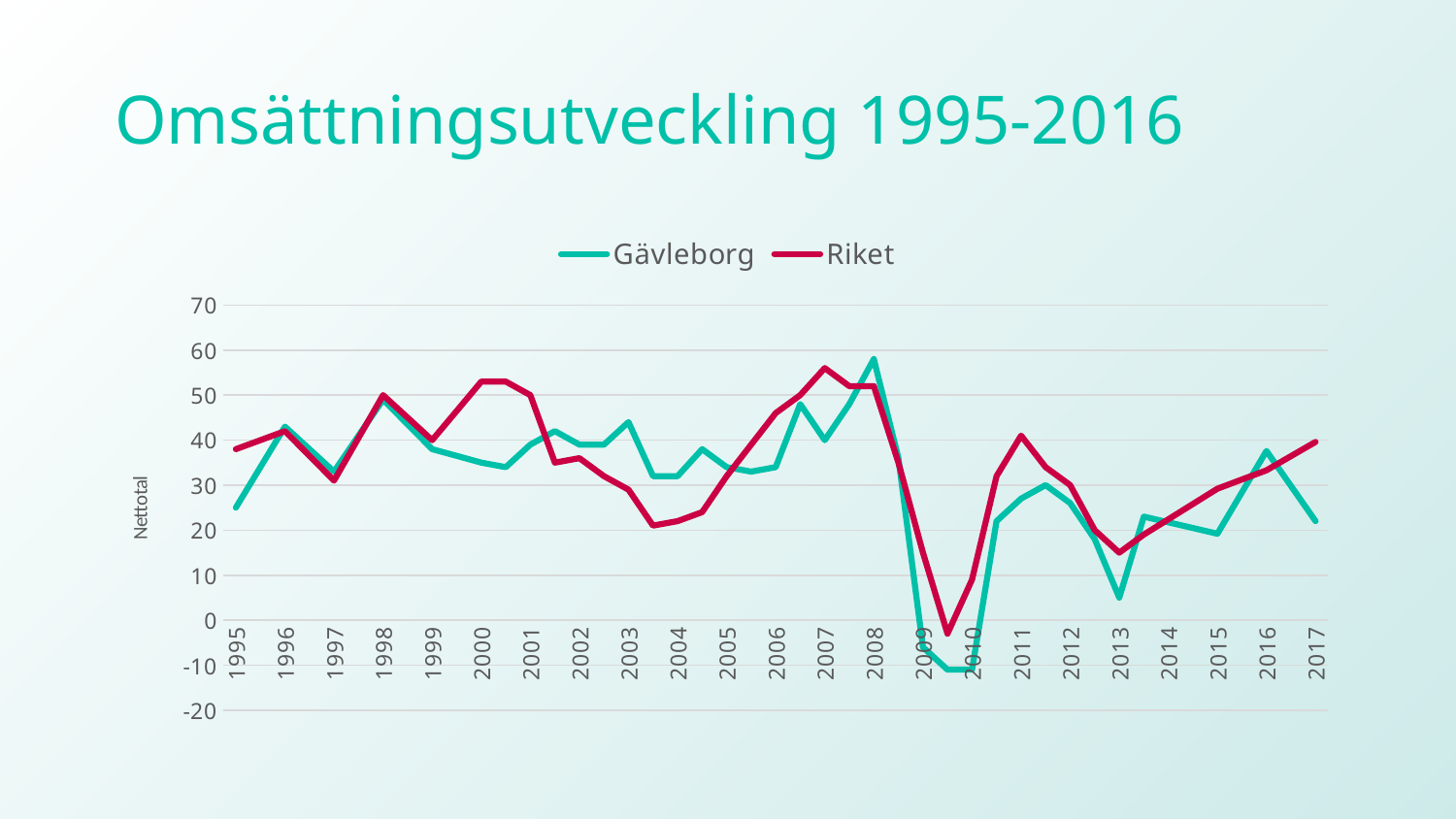
What kind of chart is shown on the slide? Line chart Does the Riket line rise or fall from 2013 to 2017? Rise What label is shown on the y axis? Nettotal In 1995, which series has the higher value, Gävleborg or Riket? Riket Is the value for Riket in 2007 greater or less than 50? greater Is the value for Gävleborg in 2013 greater or less than 10? less Is the value for Gävleborg in 2010 greater or less than 0? less How many series does the legend list? 2 In which year does the Gävleborg line reach its highest value? 2008 How many years are labelled on the x axis? 23 What is the title of the chart? Omsättningsutveckling 1995-2016